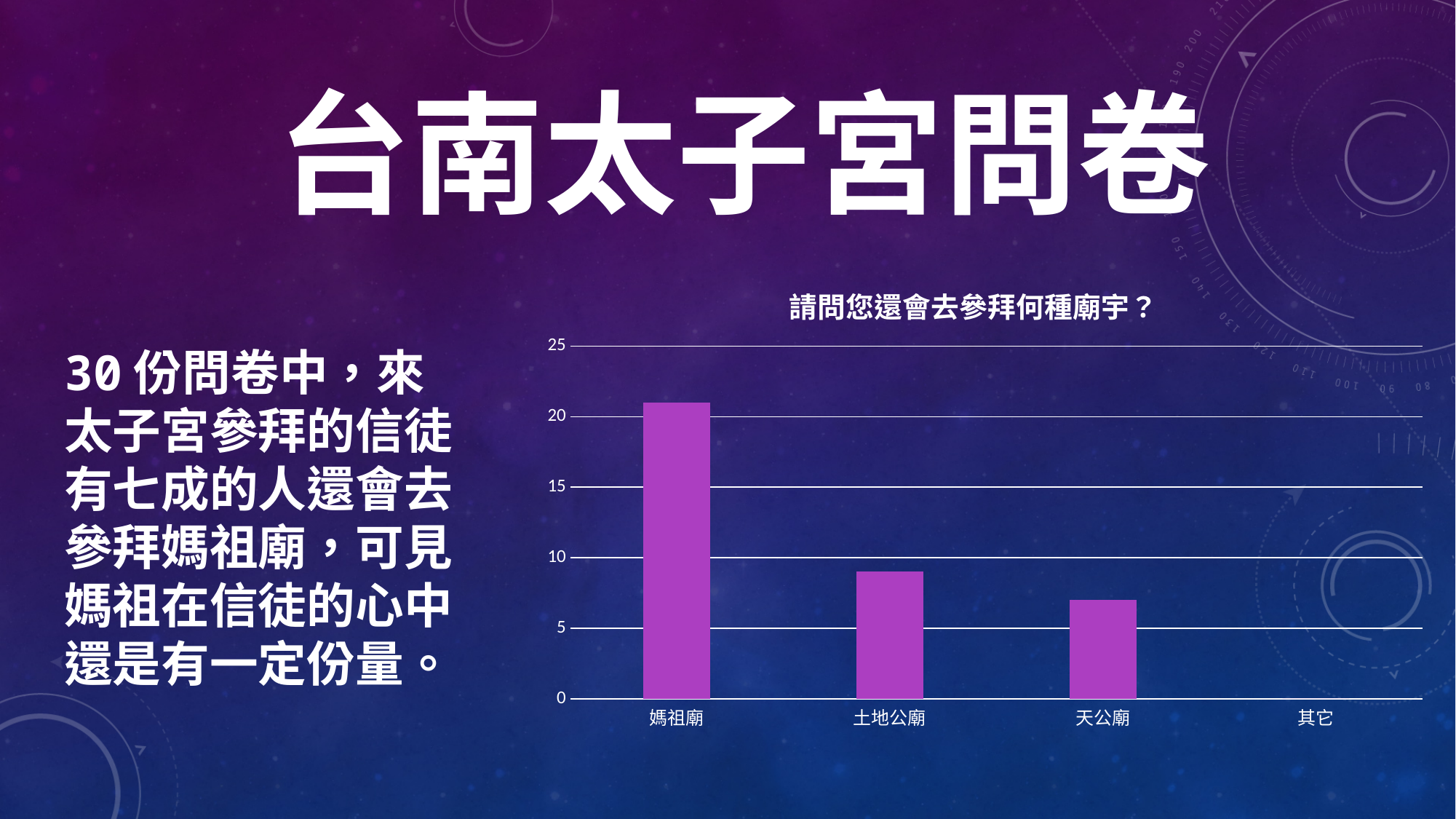
Do the bar values rise or fall from left to right along the x axis? fall Which is larger, the value for 土地公廟 or the value for 天公廟? 土地公廟 What colour are the bars in the chart? purple Is the value for 天公廟 greater or less than 5? greater Which is larger, the value for 媽祖廟 or the value for 土地公廟? 媽祖廟 Is the value for 土地公廟 greater or less than 10? less Is the value for 媽祖廟 greater or less than 15? greater Which category has the highest value in the chart? 媽祖廟 What is the title of the chart? 請問您還會去參拜何種廟宇？ What kind of chart is shown on the slide? bar chart How many categories are shown on the x axis of the chart? 4